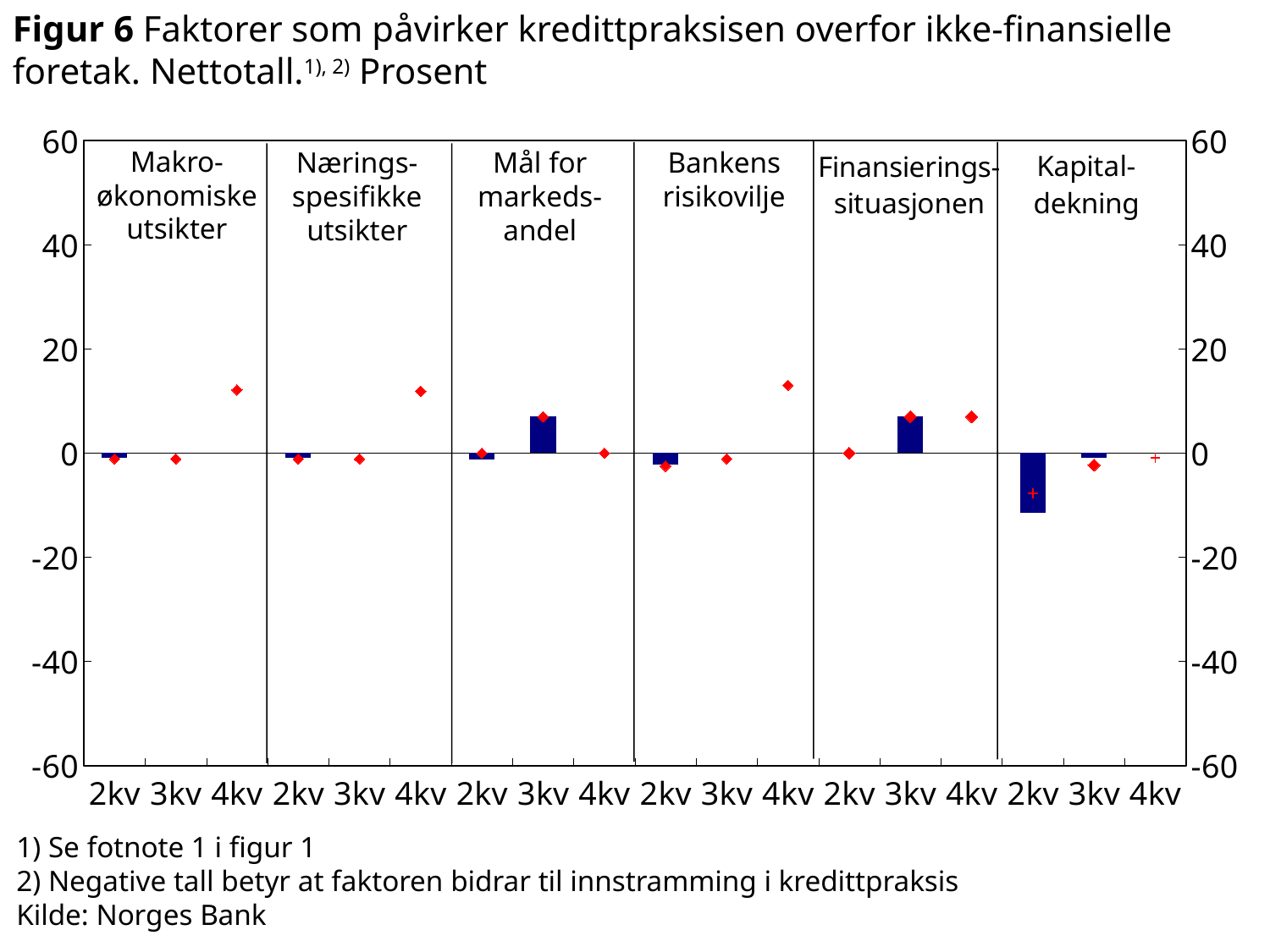
What kind of chart is shown in Figur 6? bar chart Is the bar for 2kv under Kapitaldekning greater or less than 0? less What is the source given for the chart? Norges Bank Which bar is larger: 2kv under Kapitaldekning or 3kv under Mål for markedsandel? 3kv under Mål for markedsandel Is the bar for 2kv under Kapitaldekning greater or less than -20? greater Is the bar for 3kv under Mål for markedsandel greater or less than 0? greater How many quarters (2kv, 3kv, 4kv) are shown within each factor panel? 3 How many factor panels are shown in the chart? 6 Which factor and quarter has the lowest bar in the chart? Kapitaldekning, 2kv According to footnote 2, what do negative numbers mean? The factor contributes to tightening of credit practice (innstramming i kredittpraksis)